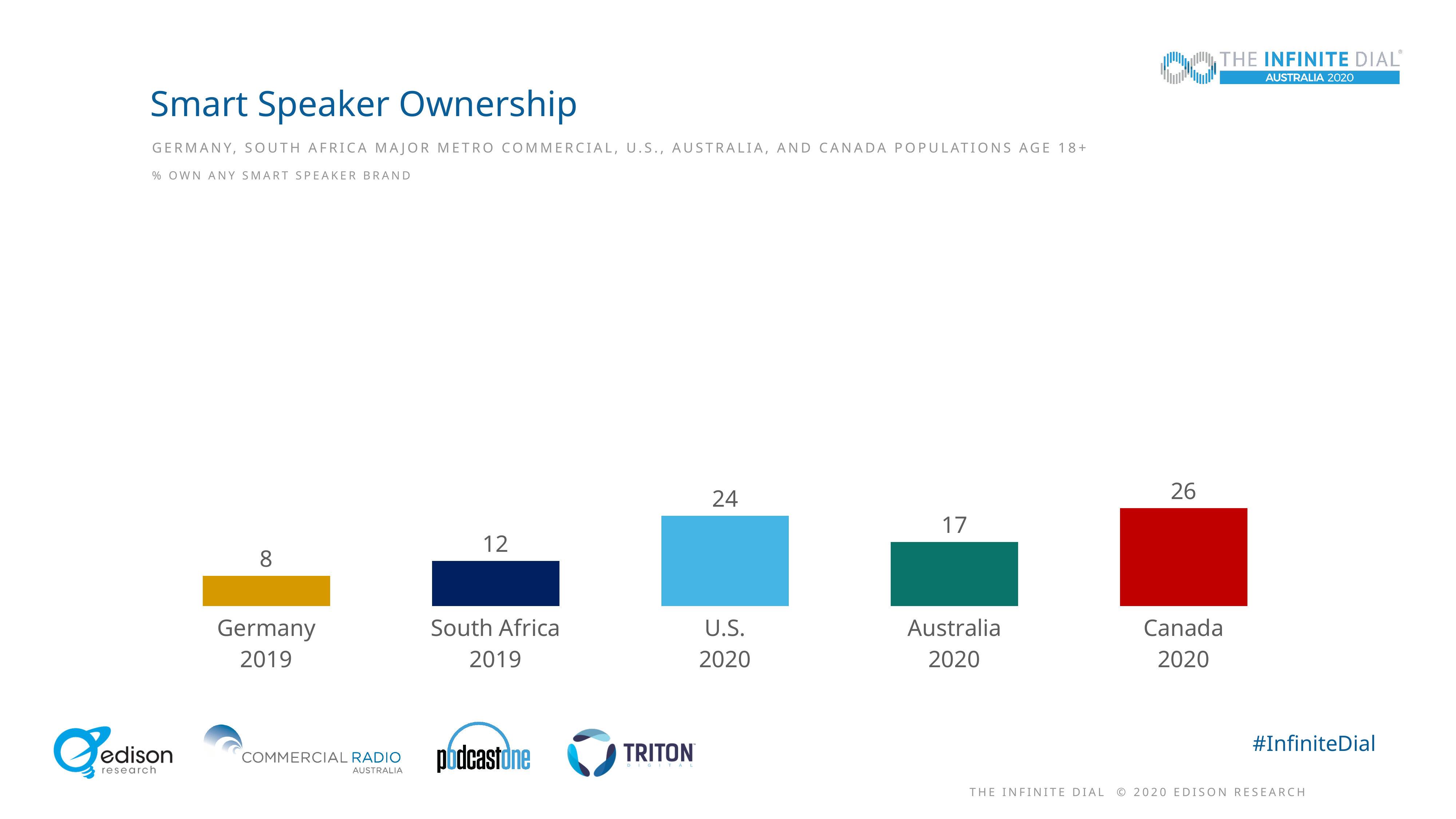
Which category has the lowest value? Germany 2019 What is the title of the chart? Smart Speaker Ownership What kind of chart is shown on the slide? Bar chart What is the value for U.S. 2020? 24 What is the value for South Africa 2019? 12 Which category has the highest value? Canada 2020 What is the value for Germany 2019? 8 What is the value for Australia 2020? 17 What is the difference between the values for Canada 2020 and Germany 2019? 18 How many categories are shown in the chart? 5 Which is larger, the value for South Africa 2019 or the value for Australia 2020? Australia 2020 What is the difference between the values for U.S. 2020 and Australia 2020? 7